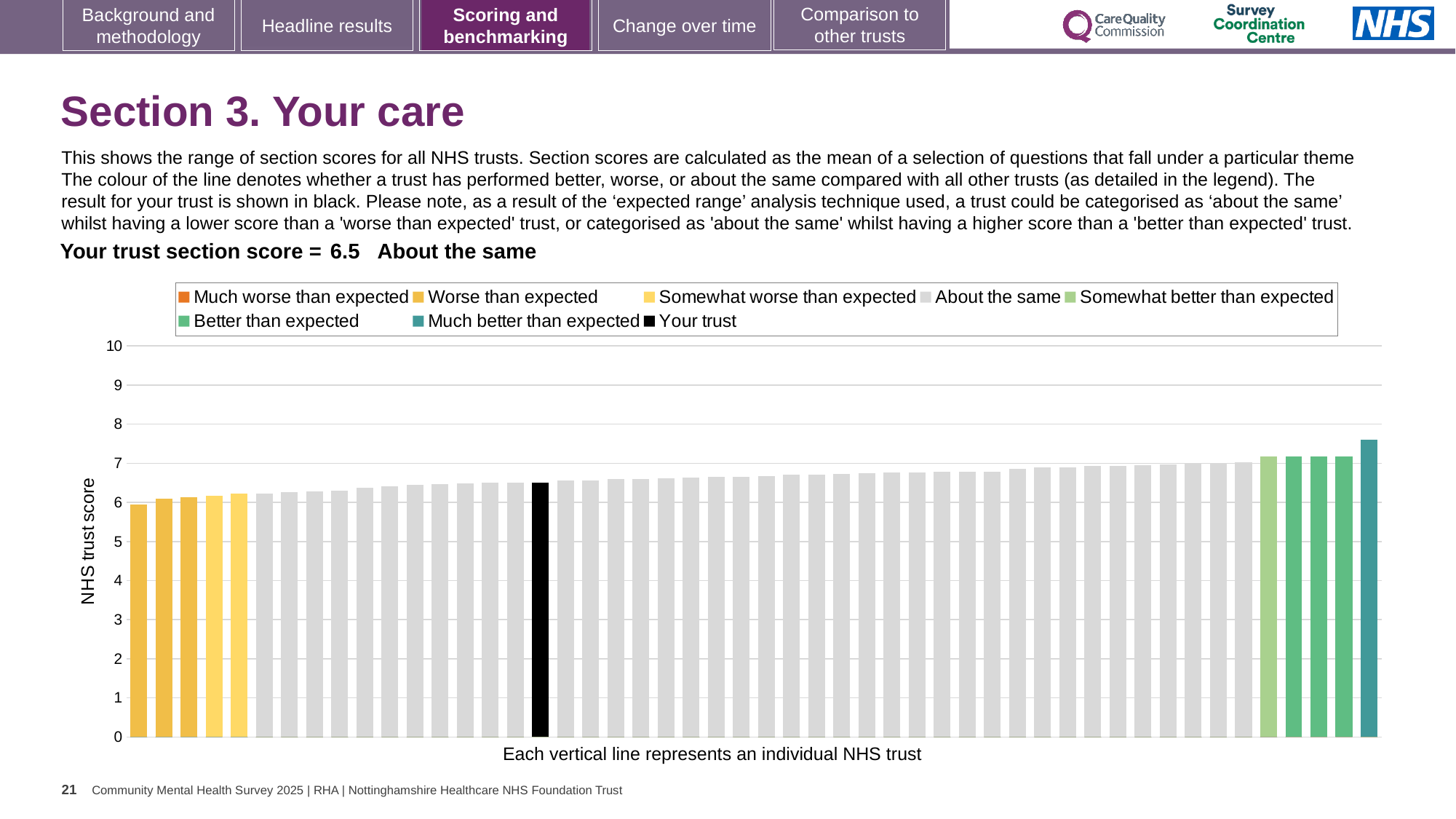
Do the bar values rise or fall from left to right along the x axis? rise Is the value of the black 'Your trust' bar greater or less than 6? greater What is the label on the vertical axis of the chart? NHS trust score What is the section score for your trust shown on the slide? 6.5 How many bars are coloured as 'Much better than expected'? 1 How many bars are coloured as 'Somewhat better than expected'? 1 What kind of chart is shown on the slide? bar chart Is the value of the lowest bar on the chart greater or less than 7? less Which category is your trust's section score placed in? About the same Is the value of the tallest bar (the 'Much better than expected' trust) greater or less than 7? greater How many entries does the chart legend list? 8 What colour is the bar representing your trust? black